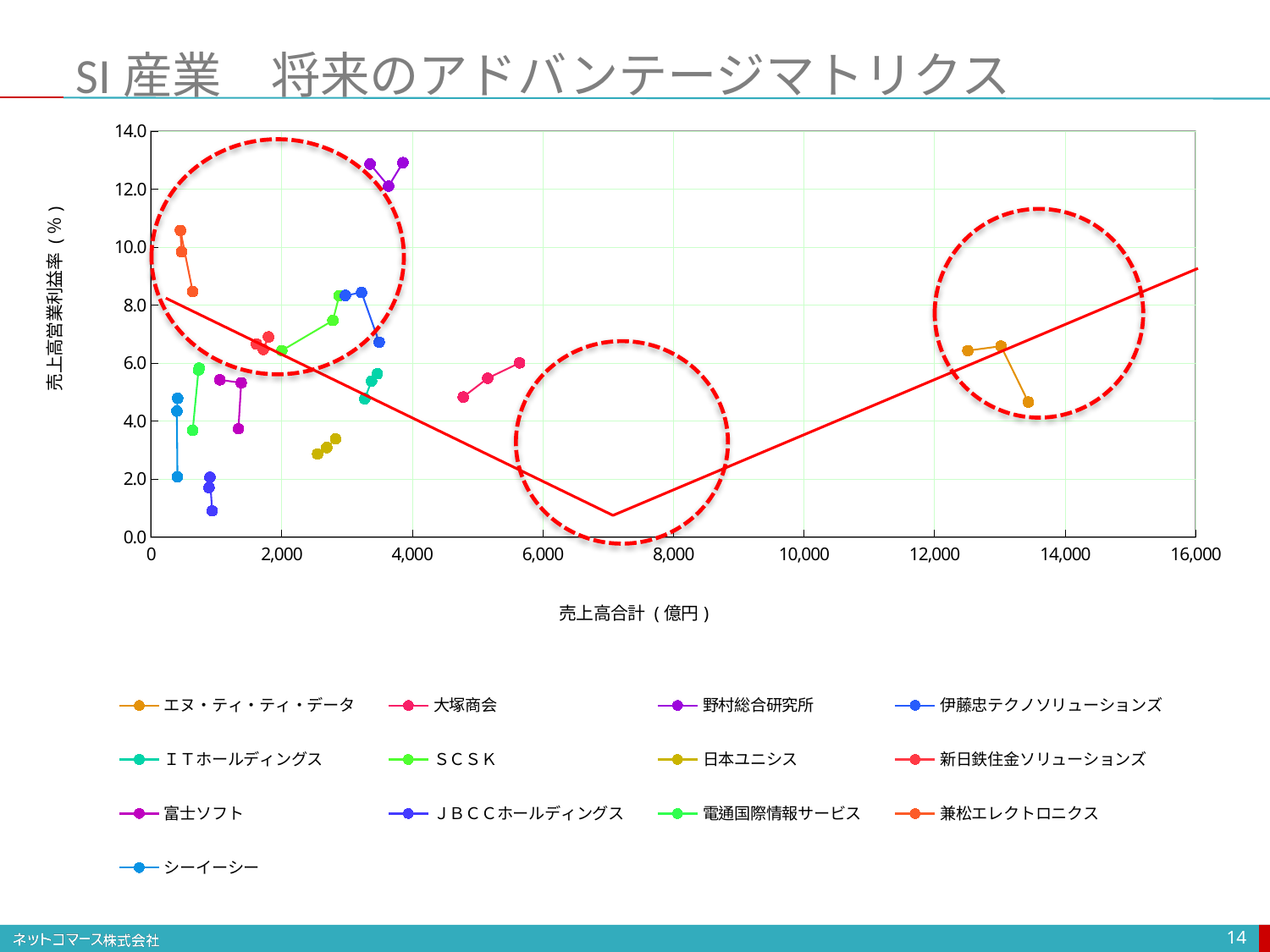
Are the 売上営業利益率 values for 日本ユニシス greater or less than 4.0? less Are the 売上高合計 values for エヌ・ティ・ティ・データ greater or less than 12,000? greater What is the title of the chart on the slide? SI産業 将来のアドバンテージマトリクス What is the label of the vertical axis? 売上高営業利益率（％） How many series does the legend list? 13 Which series has the lowest 売上営業利益率 value on the chart? ＪＢＣＣホールディングス Are the 売上営業利益率 values for 野村総合研究所 greater or less than 10.0? greater Which series is plotted furthest to the right on the 売上高合計 axis? エヌ・ティ・ティ・データ Which series has larger 売上高合計 values, 大塚商会 or 兼松エレクトロニクス? 大塚商会 Which series has the highest 売上営業利益率 values on the chart? 野村総合研究所 What kind of chart is shown on the slide? scatter chart